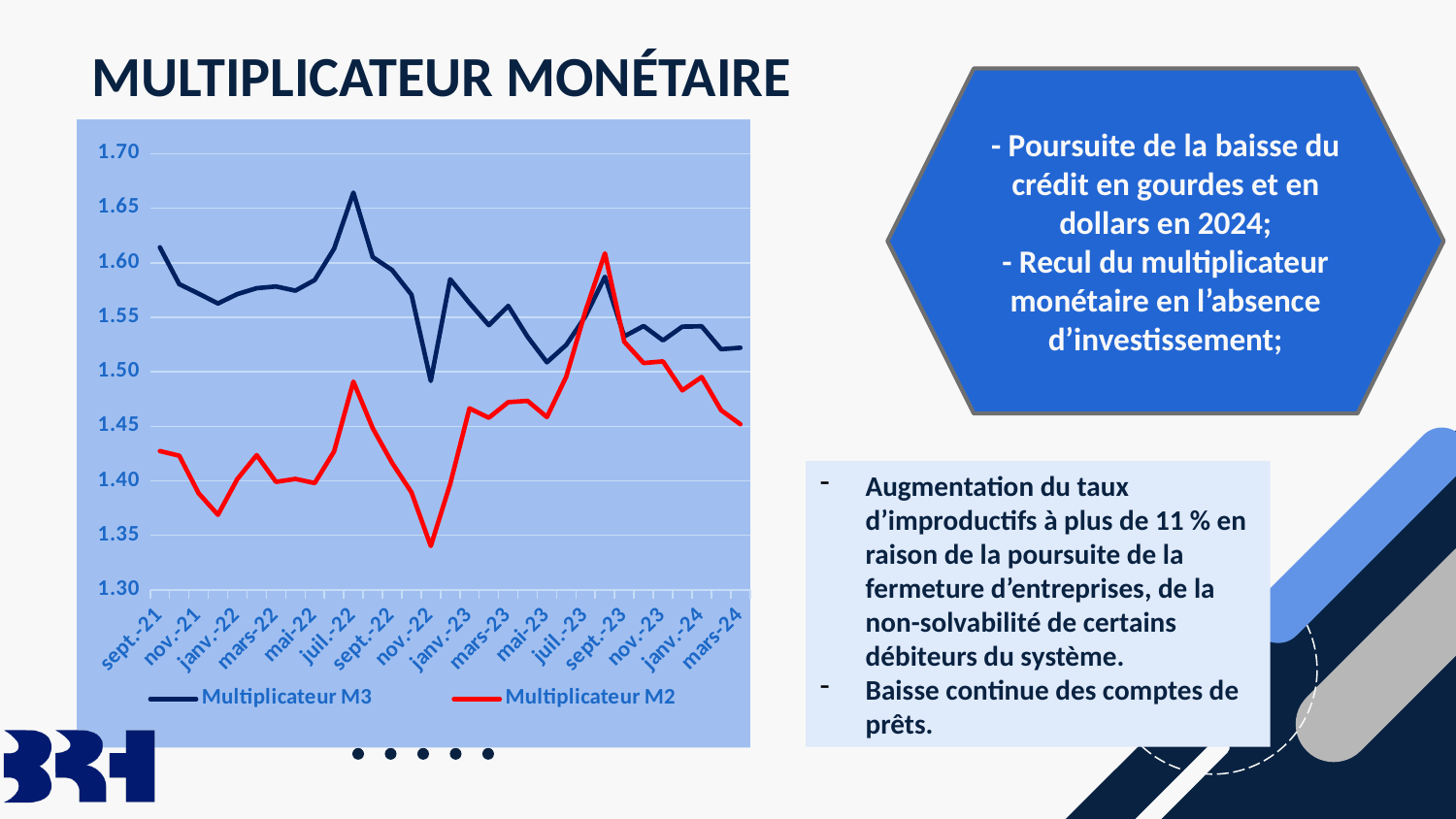
What is the title of the chart on the slide? MULTIPLICATEUR MONÉTAIRE Is the value of Multiplicateur M2 at mars-24 greater or less than 1.50? less How many series does the chart legend list? 2 Does the Multiplicateur M2 series rise or fall between sept.-23 and mars-24? fall Which series is drawn in red in the chart? Multiplicateur M2 How many date labels are shown along the x axis of the chart? 16 At sept.-21, which series has the higher value, Multiplicateur M3 or Multiplicateur M2? Multiplicateur M3 At which date does the Multiplicateur M3 series reach its highest value? juil.-22 At which date does the Multiplicateur M2 series reach its lowest value? nov.-22 Is the value of Multiplicateur M3 at juil.-22 greater or less than 1.60? greater What kind of chart is shown on the slide? line chart Is the value of Multiplicateur M2 at nov.-22 greater or less than 1.40? less